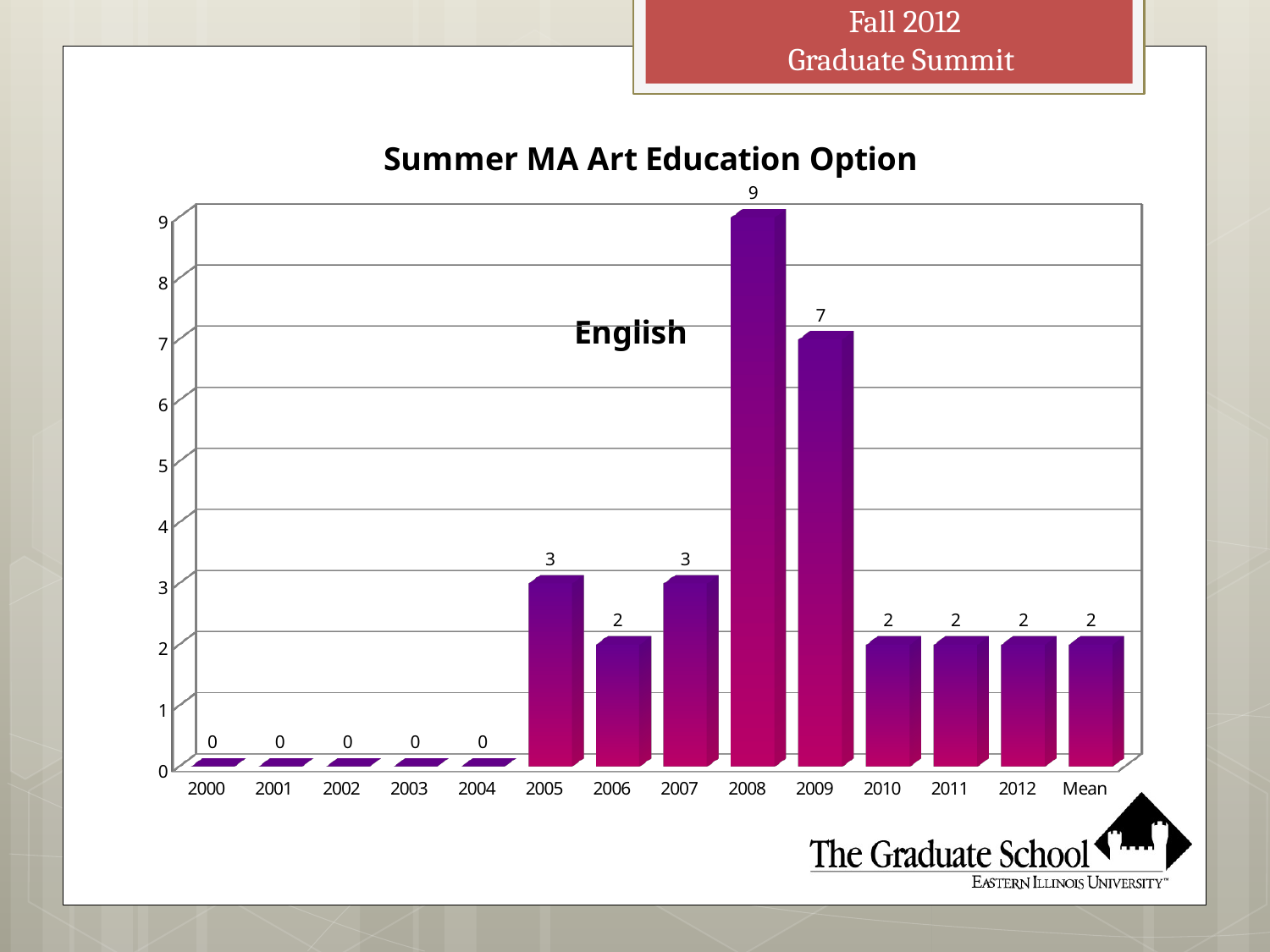
What kind of chart is this? bar chart What is the value for 2008? 9 What is the value for 2009? 7 What is the title of the chart? Summer MA Art Education Option What is the value for 2005? 3 Which category has the highest value? 2008 How many years have a value of 0? 5 What is the value shown for Mean? 2 Which is larger, the value for 2007 or the value for 2006? 2007 How many categories are shown on the x axis? 14 Do the values rise or fall from 2009 to 2010? fall What is the difference between the values for 2008 and 2009? 2